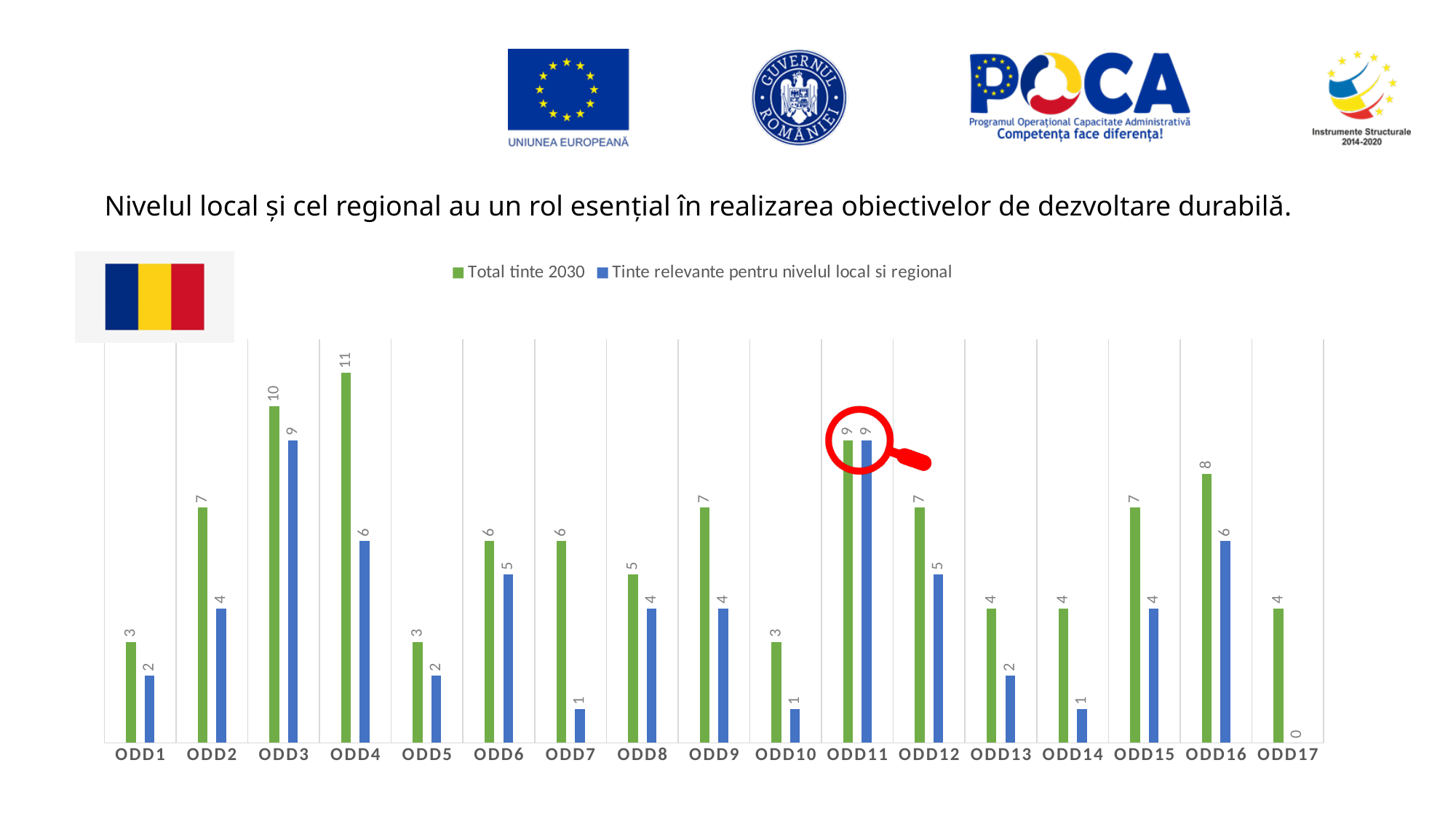
What is the value of Tinte relevante pentru nivelul local si regional for ODD3? 9 What is the value of Tinte relevante pentru nivelul local si regional for ODD17? 0 Which is larger: Total tinte 2030 for ODD16 or Total tinte 2030 for ODD12? ODD16 What is the difference between Total tinte 2030 and Tinte relevante pentru nivelul local si regional for ODD7? 5 Which category has the highest value for Total tinte 2030? ODD4 Which category has the lowest value for Tinte relevante pentru nivelul local si regional? ODD17 What kind of chart is shown on the slide? bar chart What is the value of Total tinte 2030 for ODD11? 9 What is the value of Total tinte 2030 for ODD4? 11 How many categories are shown on the x axis? 17 How many series does the legend list? 2 Which colour represents the series Total tinte 2030? green